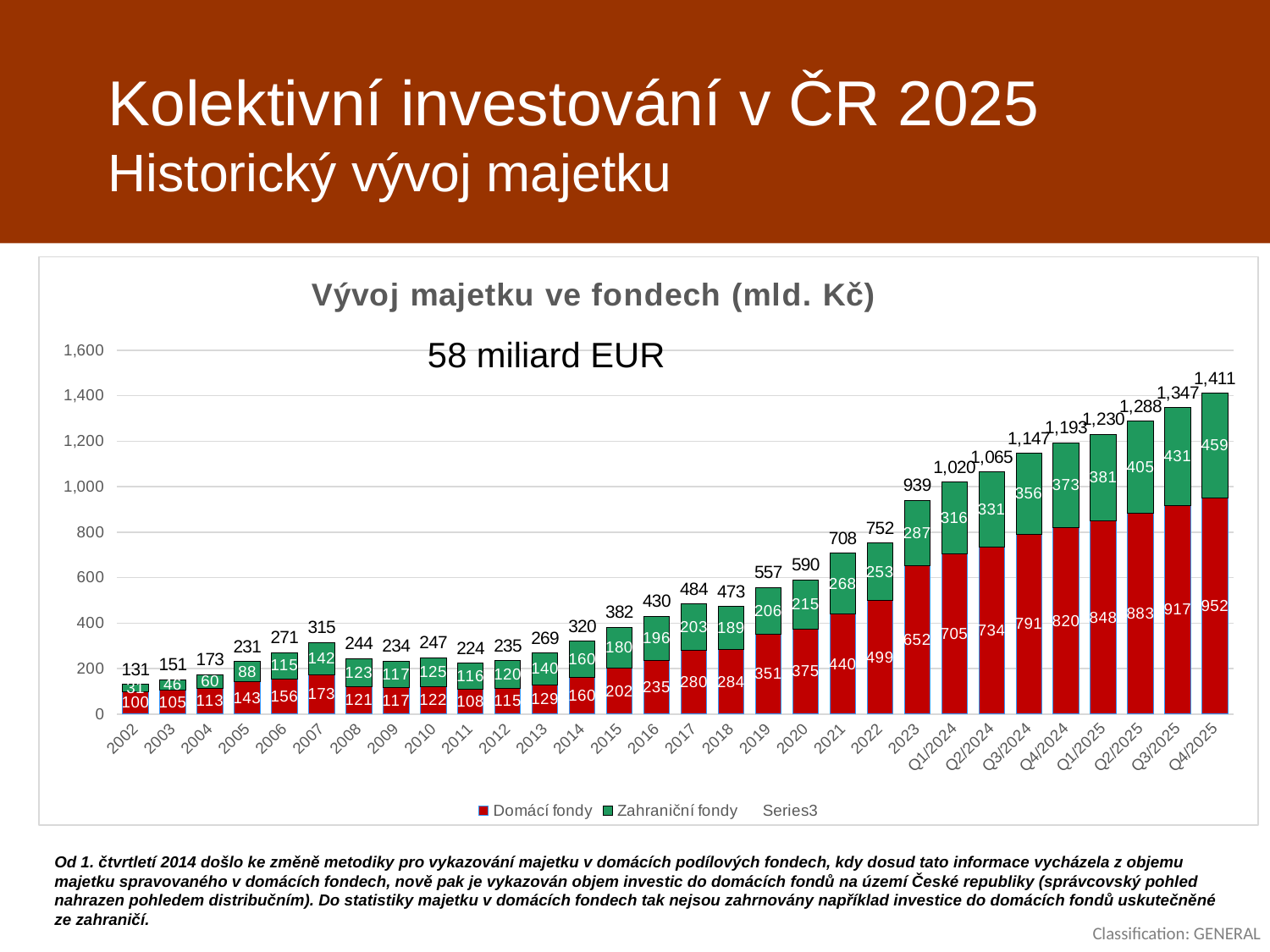
Which category has the lowest total value? 2002 Which is larger in 2008: Domácí fondy or Zahraniční fondy? Zahraniční fondy How many series does the legend list? 3 What is the title of the chart? Vývoj majetku ve fondech (mld. Kč) What is the total value of the stacked bar for Q4/2025? 1,411 How many categories are shown on the x axis? 30 What is the value for Zahraniční fondy in 2023? 287 What kind of chart is shown? Stacked bar chart What is the value for Domácí fondy in Q4/2025? 952 Which category has the highest total value? Q4/2025 What is the difference between the total for Q4/2025 and the total for Q3/2025? 64 What is the difference between the Domácí fondy value in 2023 and in 2022? 153